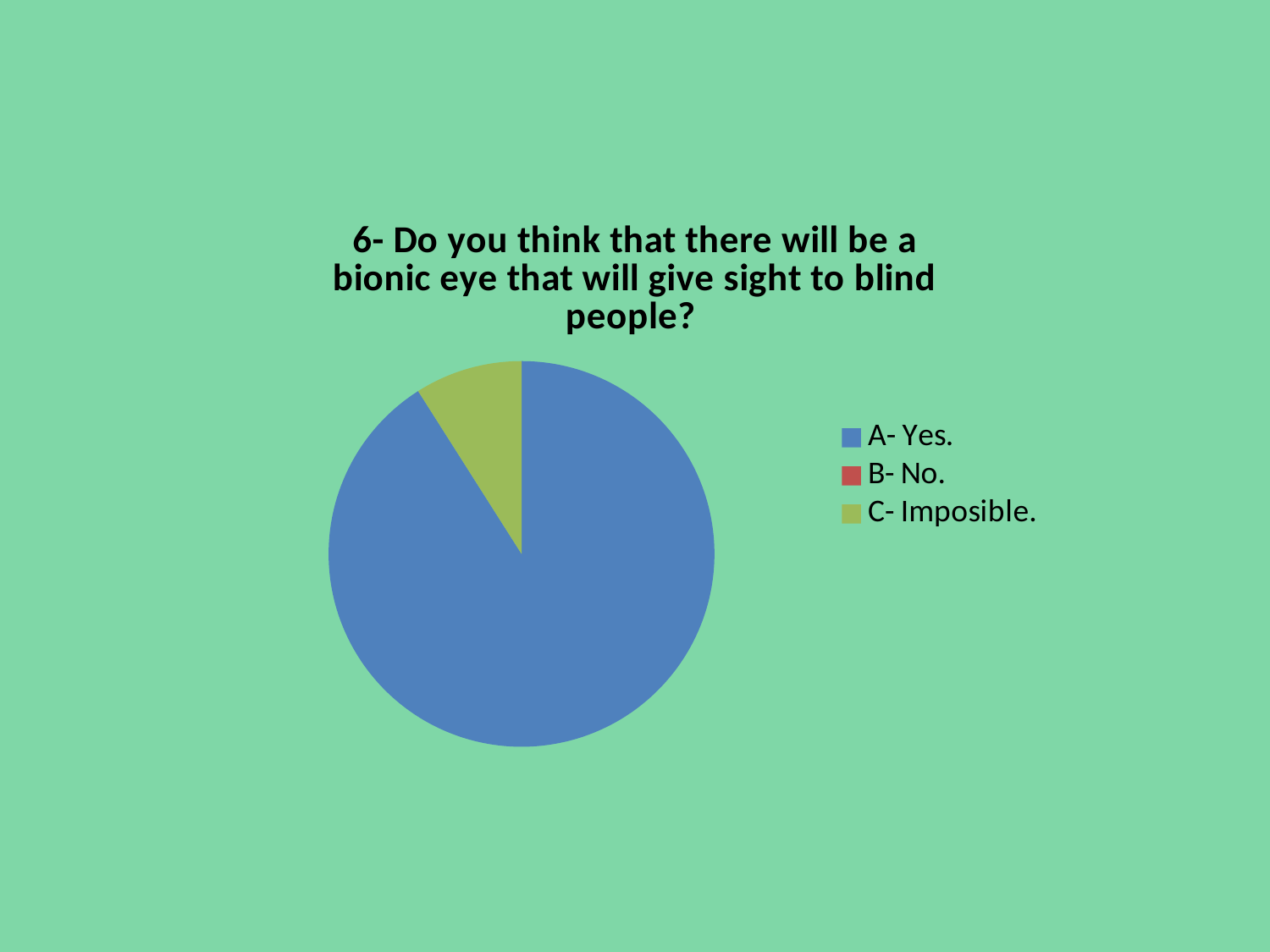
Which colour represents C- Imposible. in the chart? green How many categories does the legend list? 3 Which is larger, the slice for A- Yes. or the slice for C- Imposible.? A- Yes. What is the title of the chart? 6- Do you think that there will be a bionic eye that will give sight to blind people? Does the slice for A- Yes. cover more or less than half of the pie? more Which category has the largest slice of the pie? A- Yes. Which legend entry has no visible slice in the pie? B- No. What kind of chart is shown on the slide? pie chart